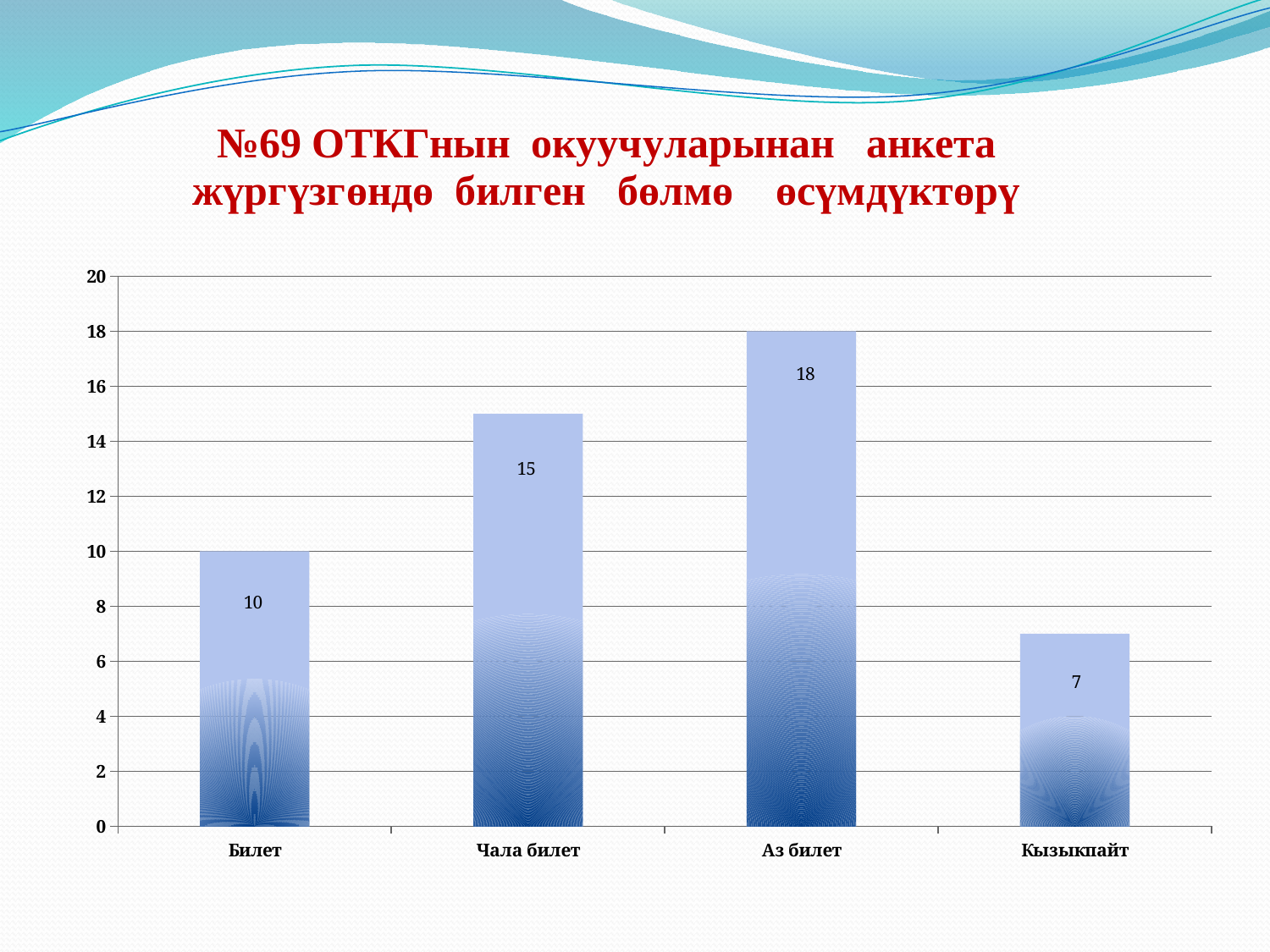
What is the difference between the values for Аз билет and Билет? 8 How many categories are shown on the x axis? 4 What kind of chart is shown on the slide? bar chart What is the value for Кызыкпайт? 7 What is the value for Аз билет? 18 Is the value for Кызыкпайт greater or less than 10? less Which category has the highest value? Аз билет What is the value for Билет? 10 Which is larger, the value for Билет or the value for Чала билет? Чала билет What is the value for Чала билет? 15 What is the difference between the values for Чала билет and Кызыкпайт? 8 Which category has the lowest value? Кызыкпайт